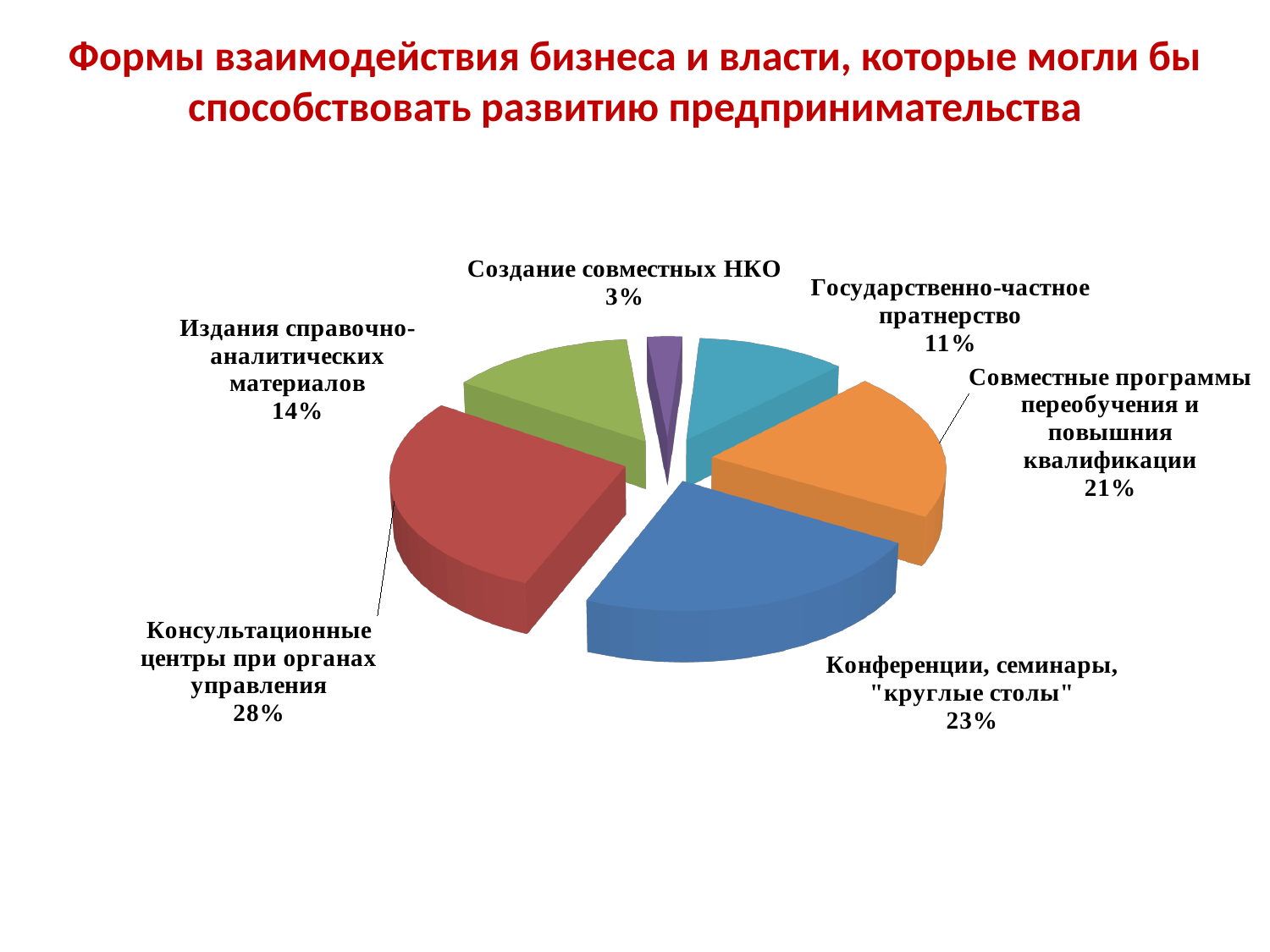
Which category has the smallest share of the pie? Создание совместных НКО What is the difference in percentage points between "Консультационные центры при органах управления" and "Издания справочно-аналитических материалов"? 14 What kind of chart is shown on the slide? Pie chart Which category has the largest share of the pie? Консультационные центры при органах управления What share of the pie does "Конференции, семинары, "круглые столы"" have? 23% Which is larger: the share for "Государственно-частное пратнерство" or the share for "Издания справочно-аналитических материалов"? Издания справочно-аналитических материалов What share of the pie does "Совместные программы переобучения и повышния квалификации" have? 21% What share of the pie does "Создание совместных НКО" have? 3% What colour is the slice for "Конференции, семинары, "круглые столы""? Blue What is the combined share of "Конференции, семинары, "круглые столы"" and "Совместные программы переобучения и повышния квалификации"? 44% How many categories (slices) does the pie chart have? 6 What share of the pie does "Консультационные центры при органах управления" have? 28%